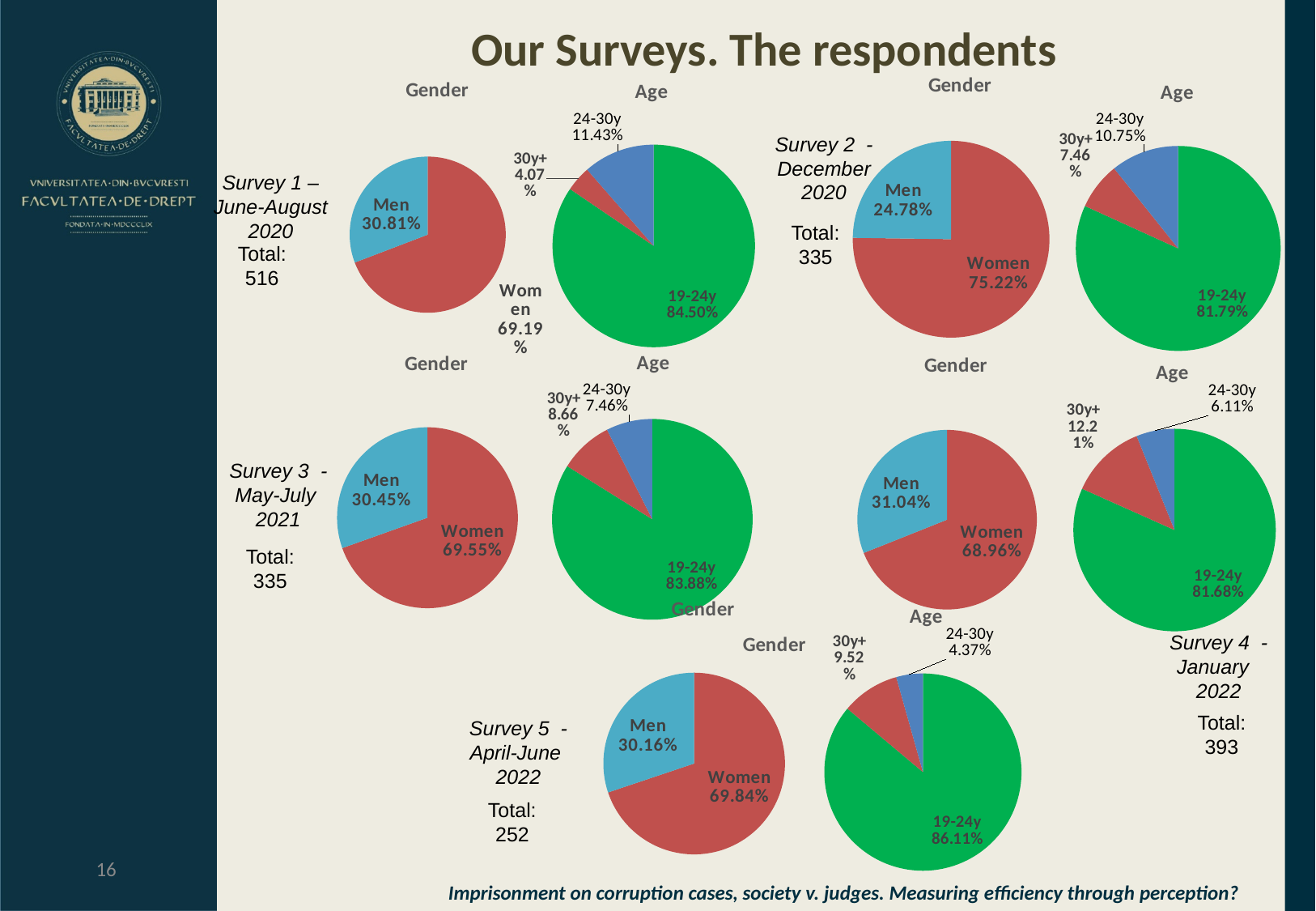
In the Survey 4 Age pie chart, what is the share of the 19-24y group? 81.68% In the Survey 2 Age pie chart, which is larger: the 24-30y share or the 30y+ share? 24-30y In the Survey 1 Age pie chart, which age group has the smallest share? 30y+ In the Survey 4 Age pie chart, what is the value for the 24-30y group? 6.11% How many pie charts are shown on the slide in total? 10 In the Survey 3 Age pie chart, what is the share of the 30y+ group? 8.66% What type of chart is used to show the Survey 4 Gender breakdown? Pie chart In the Survey 5 Age pie chart, which age group has the largest share? 19-24y In the Survey 2 Gender pie chart, what percentage of respondents are women? 75.22% How many slices does the Survey 3 Age pie chart have? 3 In the Survey 5 Gender pie chart, what is the difference between the Women and Men shares? 39.68% In the Survey 1 Gender pie chart, what share of respondents are men? 30.81%